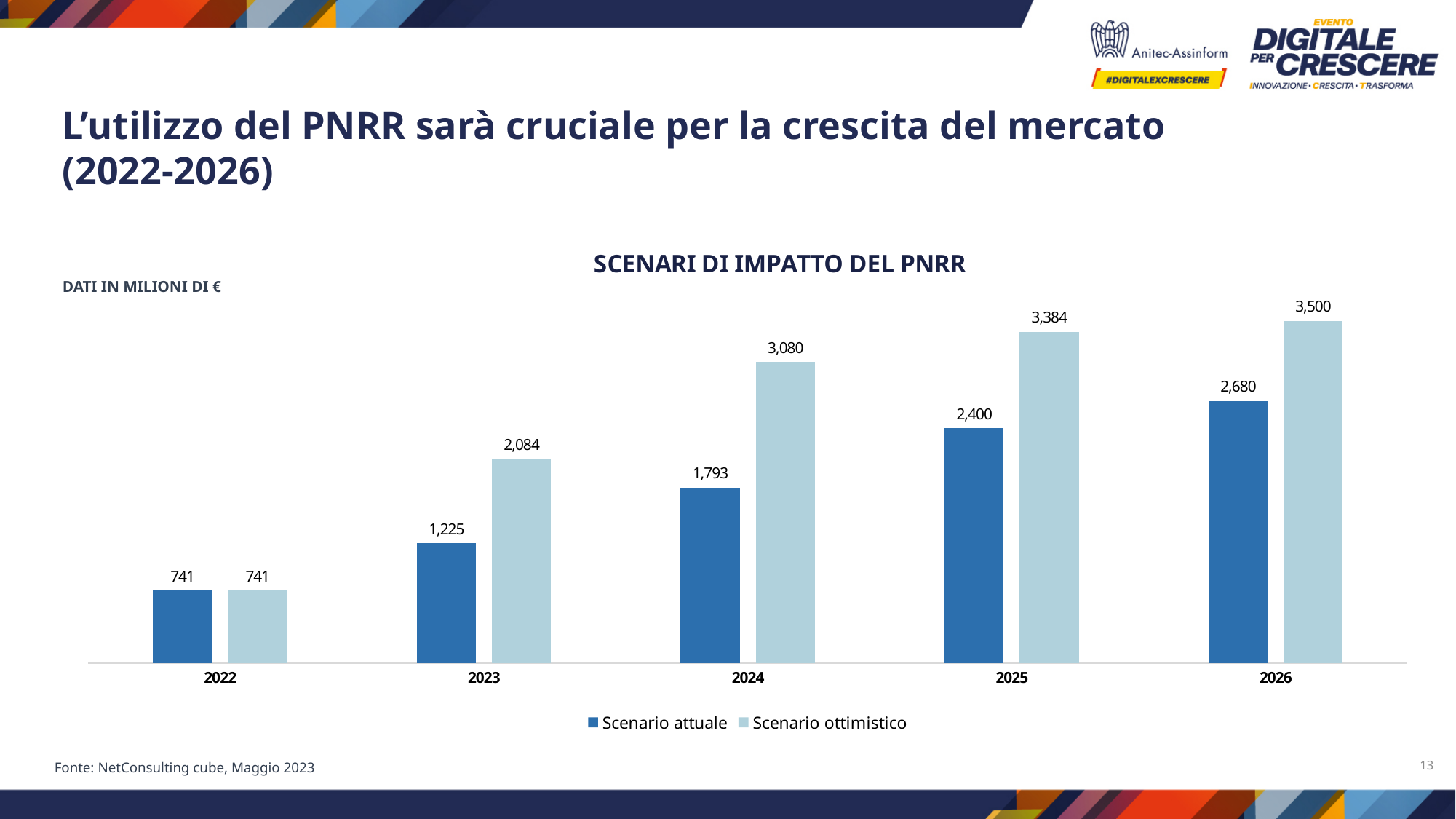
How many years are shown on the x axis? 5 Which is larger in 2023: Scenario attuale or Scenario ottimistico? Scenario ottimistico What is the value for Scenario attuale in 2024? 1,793 What is the difference between the Scenario attuale values for 2026 and 2025? 280 Do the Scenario attuale values rise or fall from 2022 to 2026? Rise What is the value for Scenario ottimistico in 2022? 741 What is the value for Scenario ottimistico in 2025? 3,384 What kind of chart is shown? Bar chart How many series does the legend list? 2 What is the difference between Scenario ottimistico and Scenario attuale in 2024? 1,287 Which year has the lowest value for Scenario attuale? 2022 Which year has the highest value for Scenario ottimistico? 2026